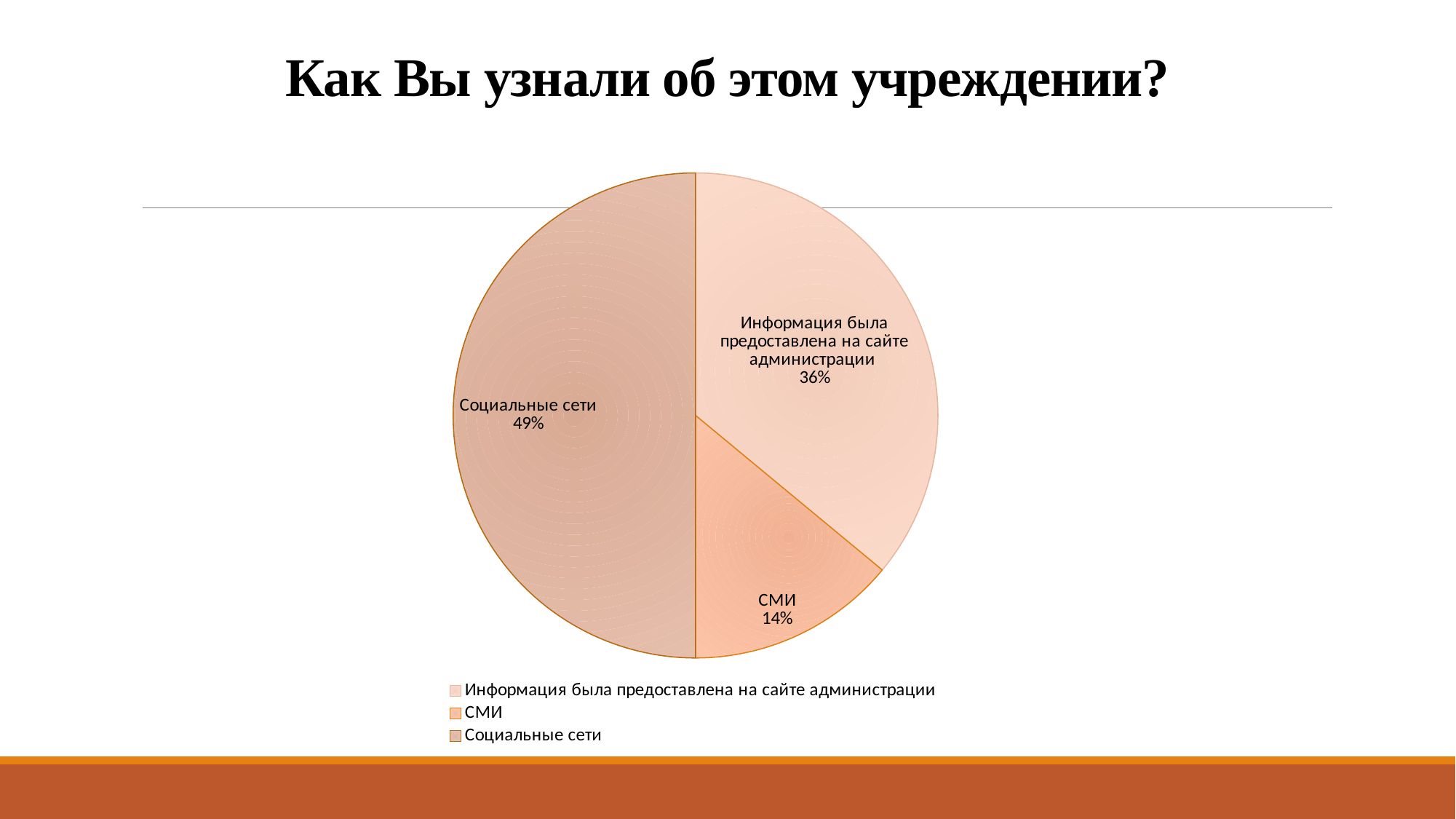
Which category has the largest slice of the pie? Социальные сети How many categories does the pie chart have? 3 What share of the pie does "Социальные сети" have? 49% What kind of chart is shown on the slide? pie chart Which is larger: the share for "СМИ" or the share for "Информация была предоставлена на сайте администрации"? Информация была предоставлена на сайте администрации What is the difference in percentage points between "Социальные сети" and "СМИ"? 35 What share of the pie does "СМИ" have? 14% What is the difference in percentage points between "Социальные сети" and "Информация была предоставлена на сайте администрации"? 13 Which category has the smallest slice of the pie? СМИ What is the title of the slide above the chart? Как Вы узнали об этом учреждении? How many entries does the legend list? 3 What share of the pie does "Информация была предоставлена на сайте администрации" have? 36%